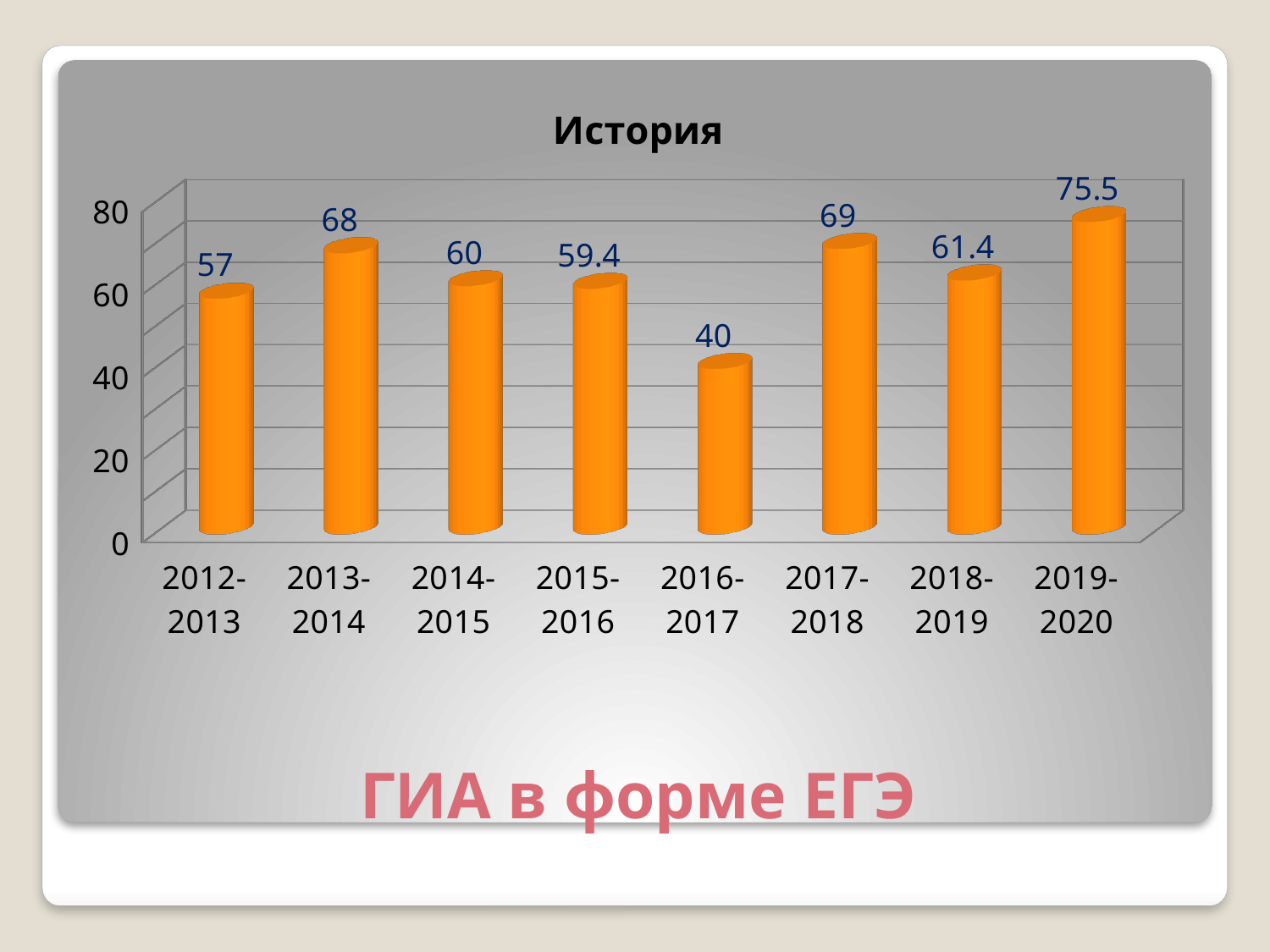
What is the title of the chart? История What is the value for 2019-2020? 75.5 What is the value for 2012-2013? 57 What is the value for 2015-2016? 59.4 Which year has the highest value? 2019-2020 Which year has the lowest value? 2016-2017 What is the difference between the values for 2019-2020 and 2016-2017? 35.5 What is the difference between the values for 2013-2014 and 2012-2013? 11 What is the value for 2016-2017? 40 Which is larger, the value for 2017-2018 or the value for 2018-2019? 2017-2018 How many categories are shown on the x axis? 8 What kind of chart is this? bar chart